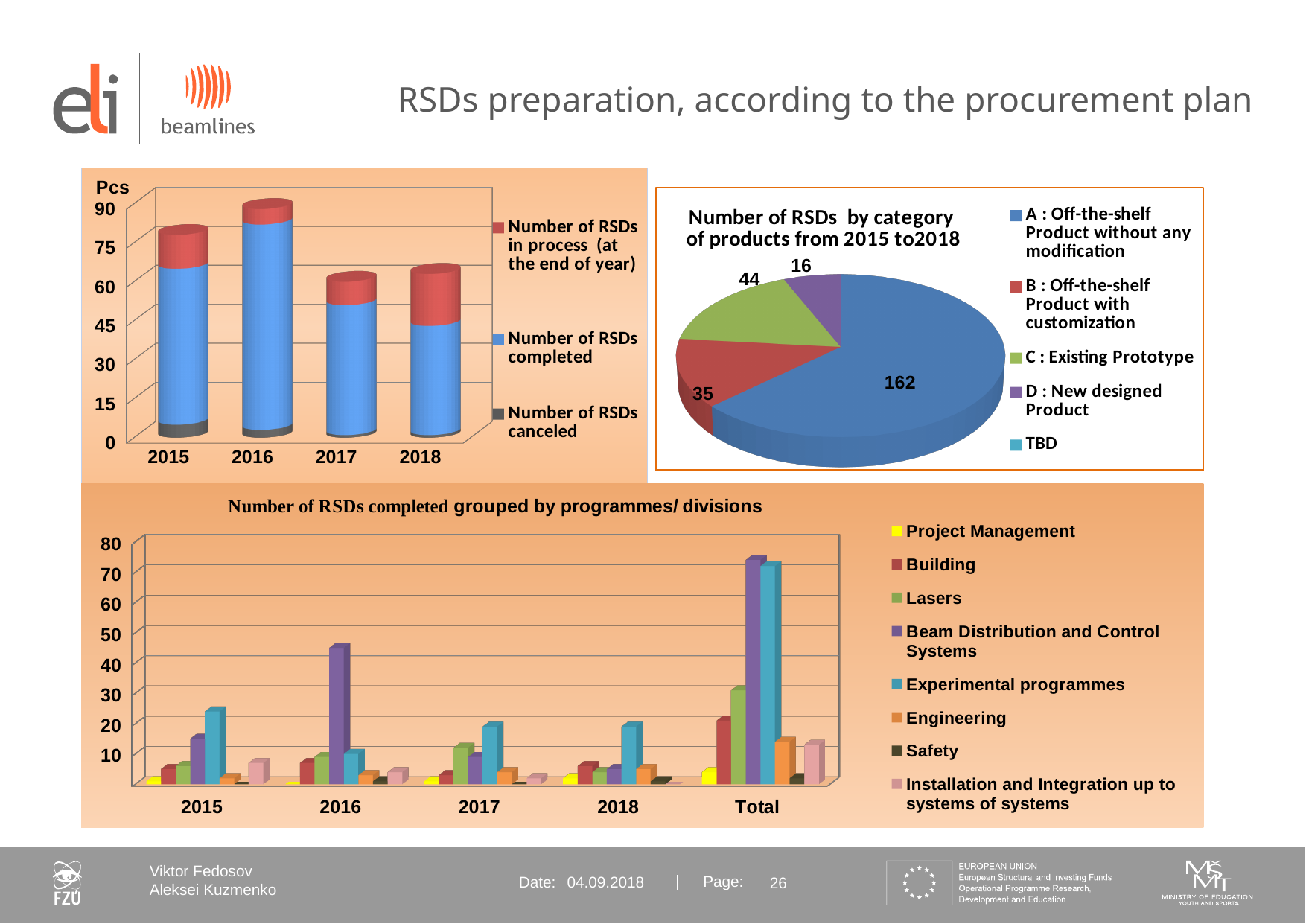
In the pie chart 'Number of RSDs by category of products from 2015 to2018', how many entries does the legend list? 5 In the top-left bar chart (Pcs by year), which year has the tallest stacked bar? 2016 In the chart 'Number of RSDs completed grouped by programmes/ divisions', how many series does the legend list? 8 What kind of chart is 'Number of RSDs completed grouped by programmes/ divisions'? bar chart In the top-left bar chart (Pcs by year), is the total height of the 2017 bar greater or less than 75? less In the pie chart 'Number of RSDs by category of products from 2015 to2018', which category has the largest number of RSDs? A : Off-the-shelf Product without any modification In the top-left bar chart (Pcs by year), how many series does the legend list? 3 In the chart 'Number of RSDs completed grouped by programmes/ divisions', which series has the tallest bar for 2016? Beam Distribution and Control Systems In the pie chart 'Number of RSDs by category of products from 2015 to2018', what is the difference between the values for category A and category C? 118 In the pie chart 'Number of RSDs by category of products from 2015 to2018', what is the value for C : Existing Prototype? 44 In the top-left bar chart (Pcs by year), how many years are shown on the x axis? 4 In the pie chart 'Number of RSDs by category of products from 2015 to2018', what is the value for B : Off-the-shelf Product with customization? 35